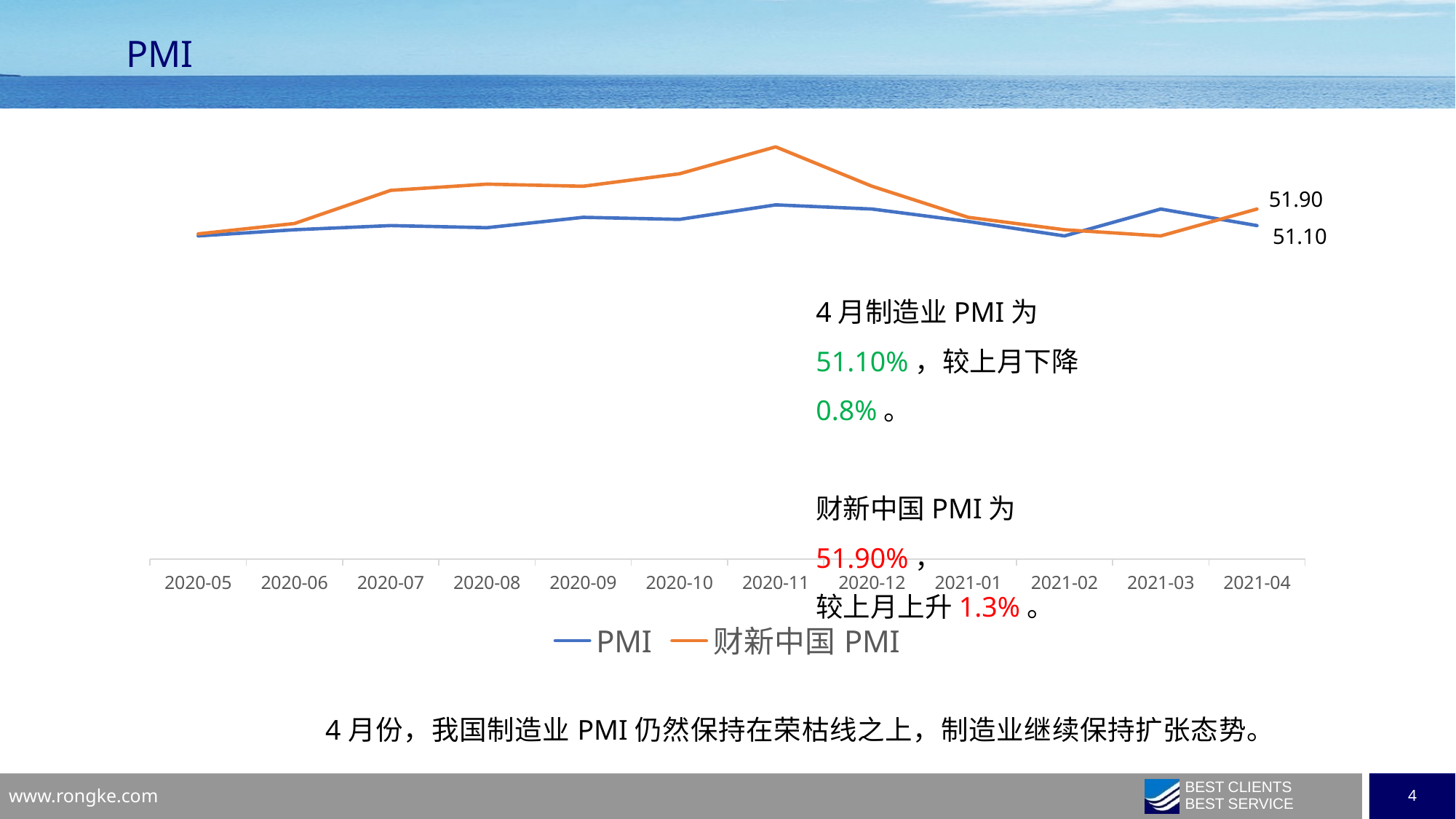
Does 财新中国 PMI rise or fall from 2020-11 to 2021-03? Fall How many months are shown on the x axis of the chart? 12 What is the difference between 财新中国 PMI and PMI for 2021-04? 0.80 For 2020-11, which series has the higher value, PMI or 财新中国 PMI? 财新中国 PMI What is the value of 财新中国 PMI for 2021-04? 51.90 How many series does the chart's legend list? 2 For 2021-04, which series has the higher value, PMI or 财新中国 PMI? 财新中国 PMI What colour is the 财新中国 PMI line in the chart? Orange What is the value of PMI for 2021-04? 51.10 For 2021-03, which series has the higher value, PMI or 财新中国 PMI? PMI In which month does 财新中国 PMI reach its highest value? 2020-11 What kind of chart is shown on the slide? Line chart